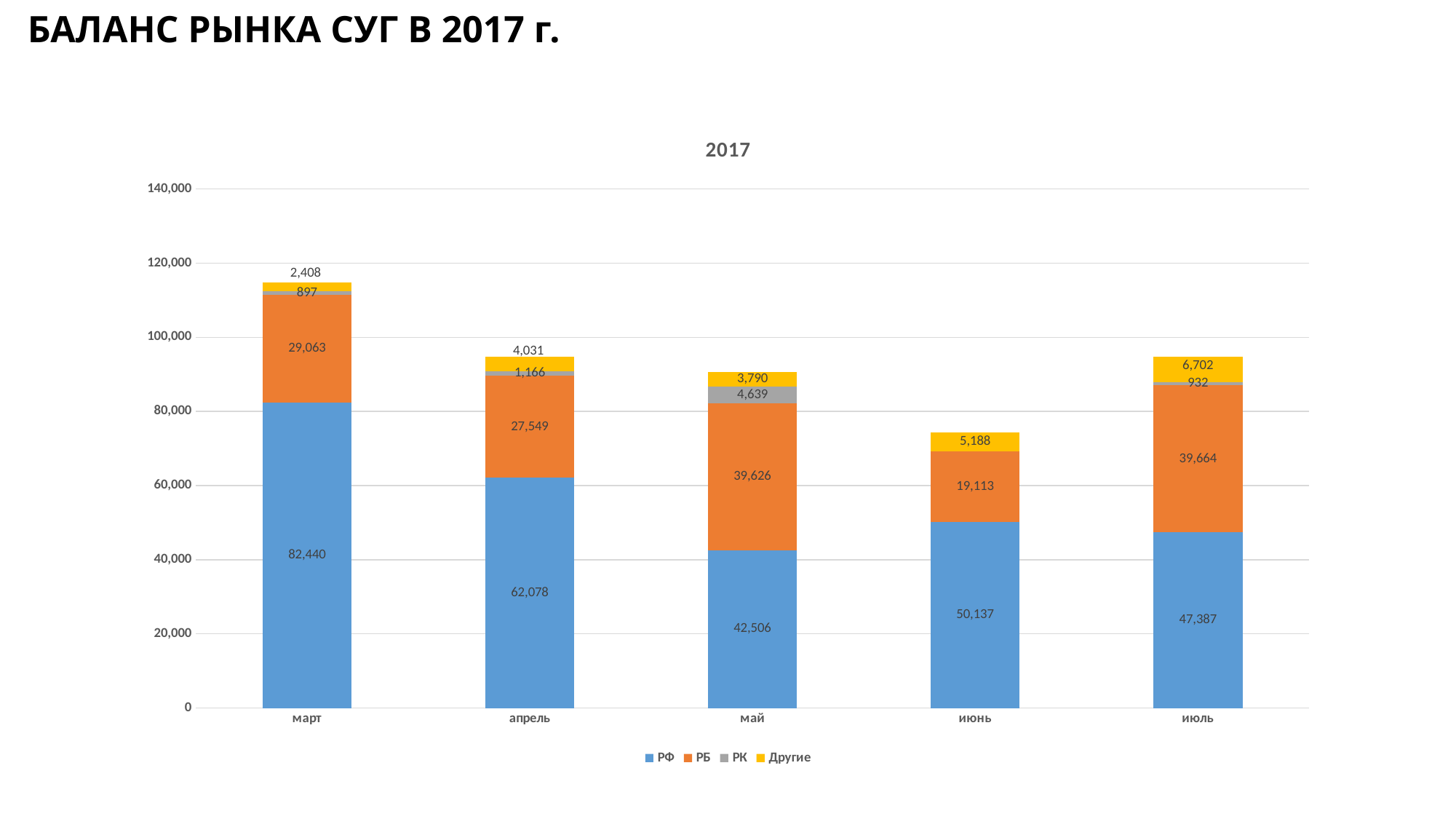
In which month is the РФ value highest? март Is the total stacked bar for июнь greater or less than 80,000? less What is the total of the stacked bar for март? 114,808 How many months are shown on the x axis? 5 What is the difference between the РФ values for март and апрель? 20,362 What is the value for РБ in май? 39,626 How many series does the legend list? 4 What is the value for Другие in июль? 6,702 Which is larger: the РК value in май or the РК value in апрель? май What kind of chart is shown on the slide? stacked bar chart What is the value for РФ in март? 82,440 In which month is the РБ value lowest? июнь